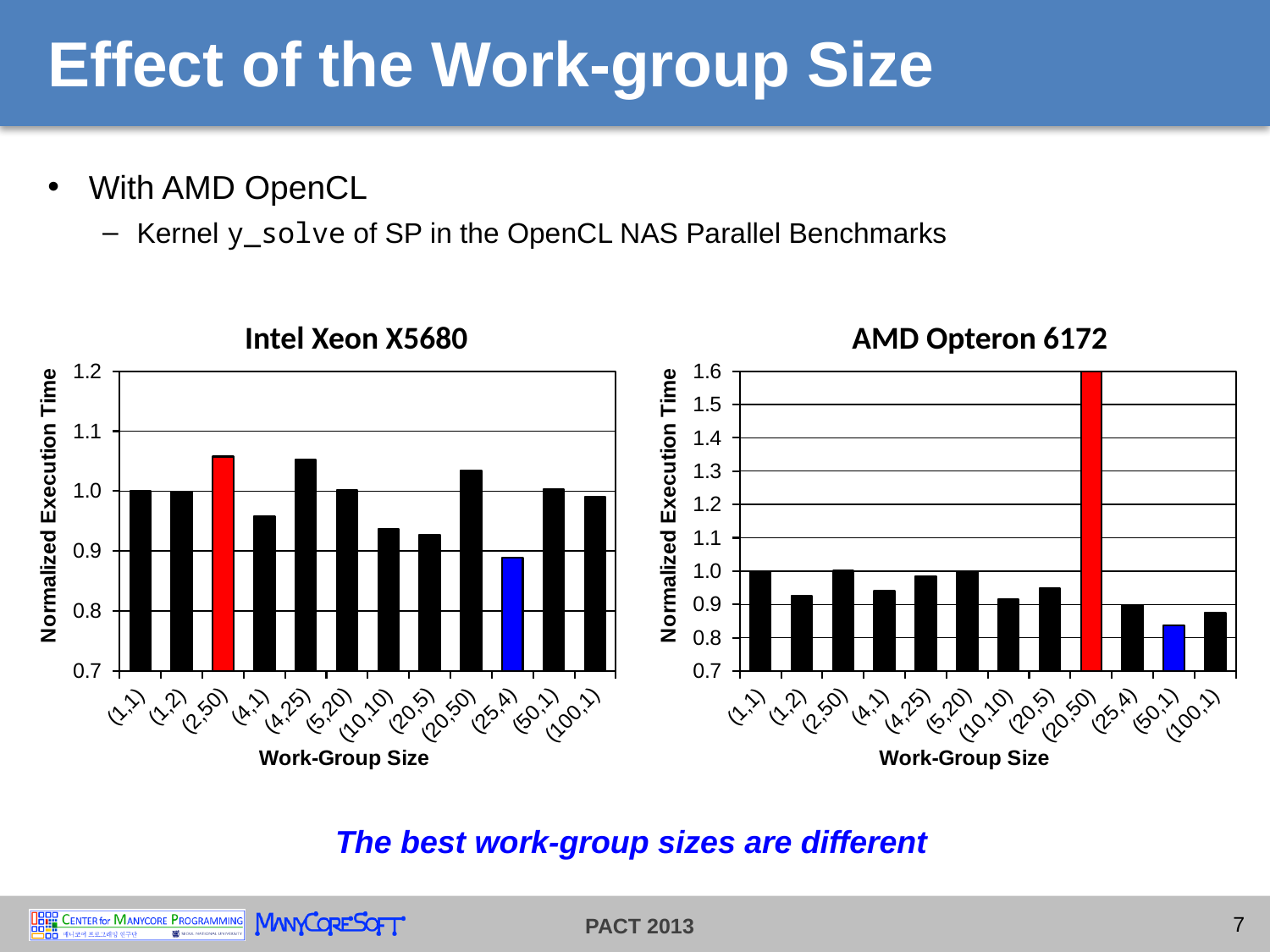
On the AMD Opteron 6172 chart, which work-group size has the highest normalized execution time? (20,50) On the AMD Opteron 6172 chart, is the value for (1,2) greater or less than 1.0? less On the Intel Xeon X5680 chart, is the value for (25,4) greater or less than 0.9? less On the Intel Xeon X5680 chart, is the value for (2,50) greater or less than 1.0? greater On the AMD Opteron 6172 chart, which work-group size has the lowest normalized execution time? (50,1) How many work-group sizes are plotted on the AMD Opteron 6172 chart? 12 What kind of chart is the Intel Xeon X5680 chart? bar chart What is the y-axis label on the Intel Xeon X5680 chart? Normalized Execution Time On the Intel Xeon X5680 chart, which is larger, the value for (2,50) or the value for (25,4)? (2,50) On the AMD Opteron 6172 chart, which is larger, the value for (20,50) or the value for (1,1)? (20,50) On the Intel Xeon X5680 chart, which work-group size has the lowest normalized execution time? (25,4)